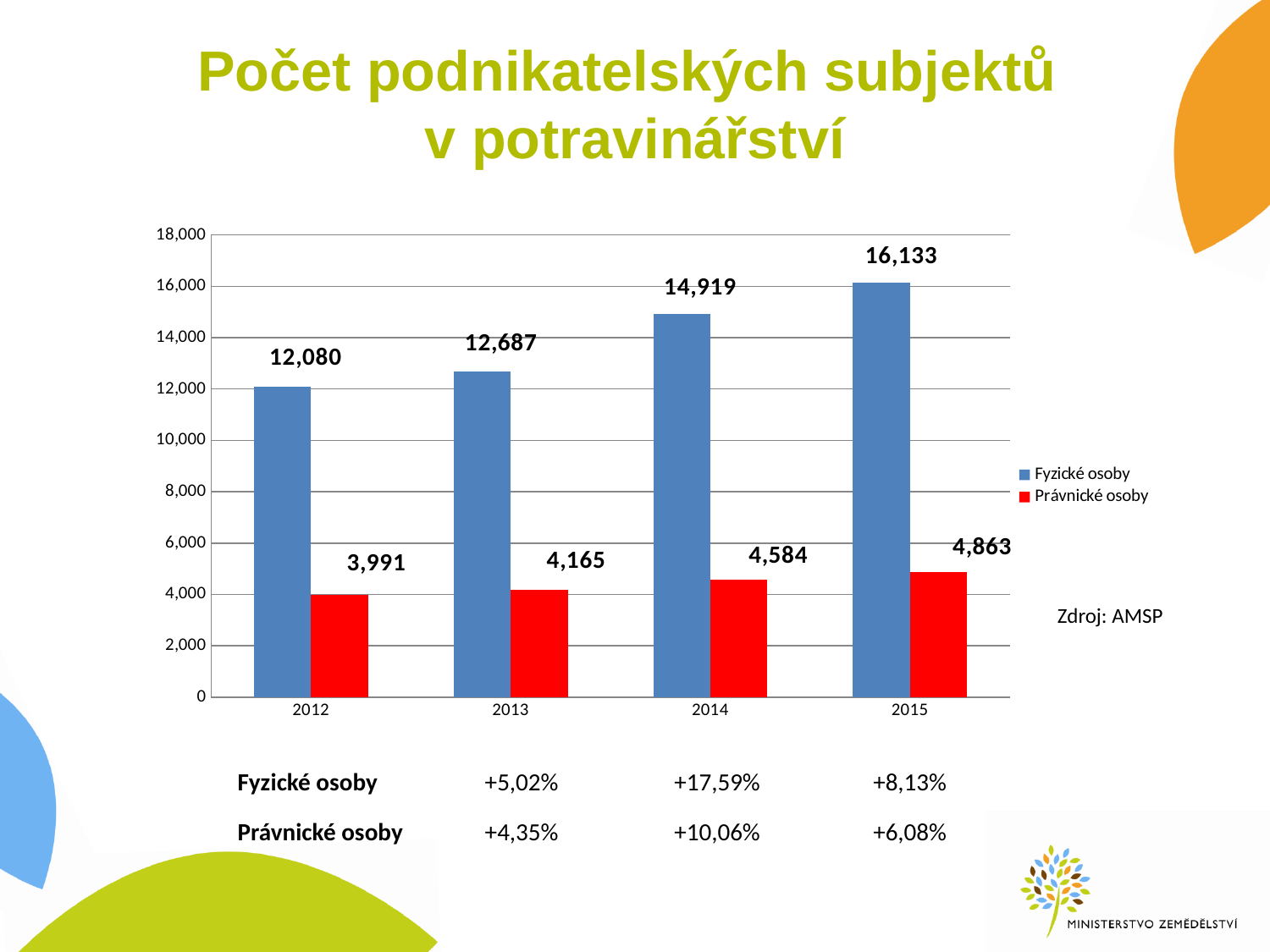
Which is larger: Fyzické osoby in 2012 or Právnické osoby in 2015? Fyzické osoby in 2012 What is the difference between the Fyzické osoby values for 2015 and 2014? 1,214 What is the value for Právnické osoby in 2012? 3,991 What is the value for Právnické osoby in 2014? 4,584 How many series does the legend list? 2 What is the value for Fyzické osoby in 2013? 12,687 Do the values for Právnické osoby rise or fall from 2012 to 2015? rise In which year is the value for Právnické osoby lowest? 2012 What is the value for Fyzické osoby in 2015? 16,133 What kind of chart is shown on the slide? bar chart In which year is the value for Fyzické osoby highest? 2015 How many years are shown on the x axis? 4